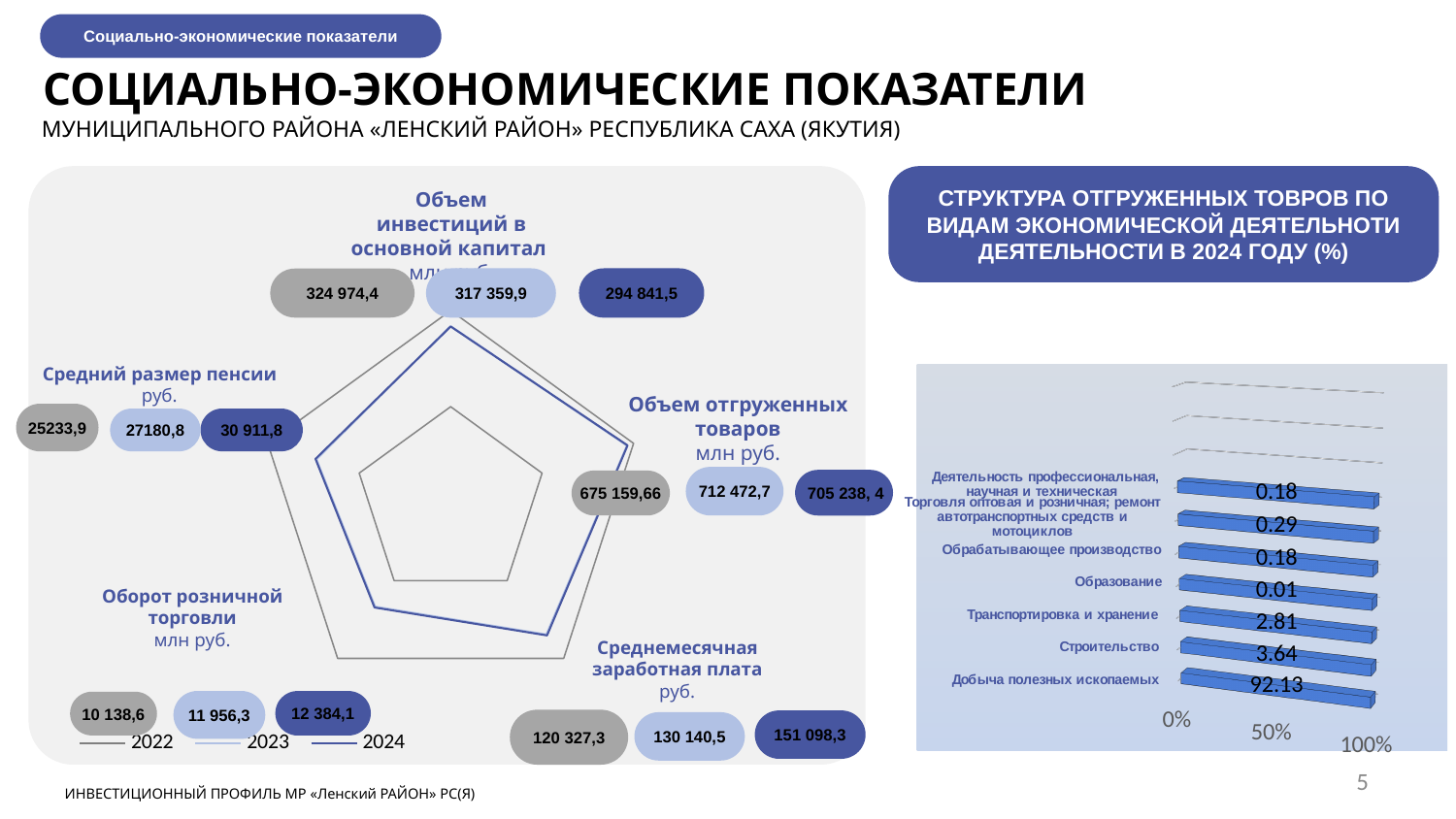
On the left radar chart, how many series does the legend list? 3 On the right chart (structure of shipped goods in 2024), what is the value for Добыча полезных ископаемых? 92.13 On the left radar chart, what is the difference between Средний размер пенсии in 2024 and in 2023? 3 731,0 On the left radar chart, what is the value of Объем инвестиций в основной капитал for 2024? 294 841,5 On the right chart (structure of shipped goods in 2024), what kind of chart is it? Bar chart On the right chart (structure of shipped goods in 2024), which labelled category has the lowest value? Образование On the left radar chart, which is larger: Объем отгруженных товаров in 2023 or in 2024? 2023 On the left radar chart, what is the value of Среднемесячная заработная плата for 2022? 120 327,3 On the right chart (structure of shipped goods in 2024), what is the value for Строительство? 3.64 On the right chart (structure of shipped goods in 2024), which labelled category has the highest value? Добыча полезных ископаемых On the right chart (structure of shipped goods in 2024), what is the difference between Строительство and Транспортировка и хранение? 0.83 On the left radar chart, how many indicators (axes) are plotted? 5